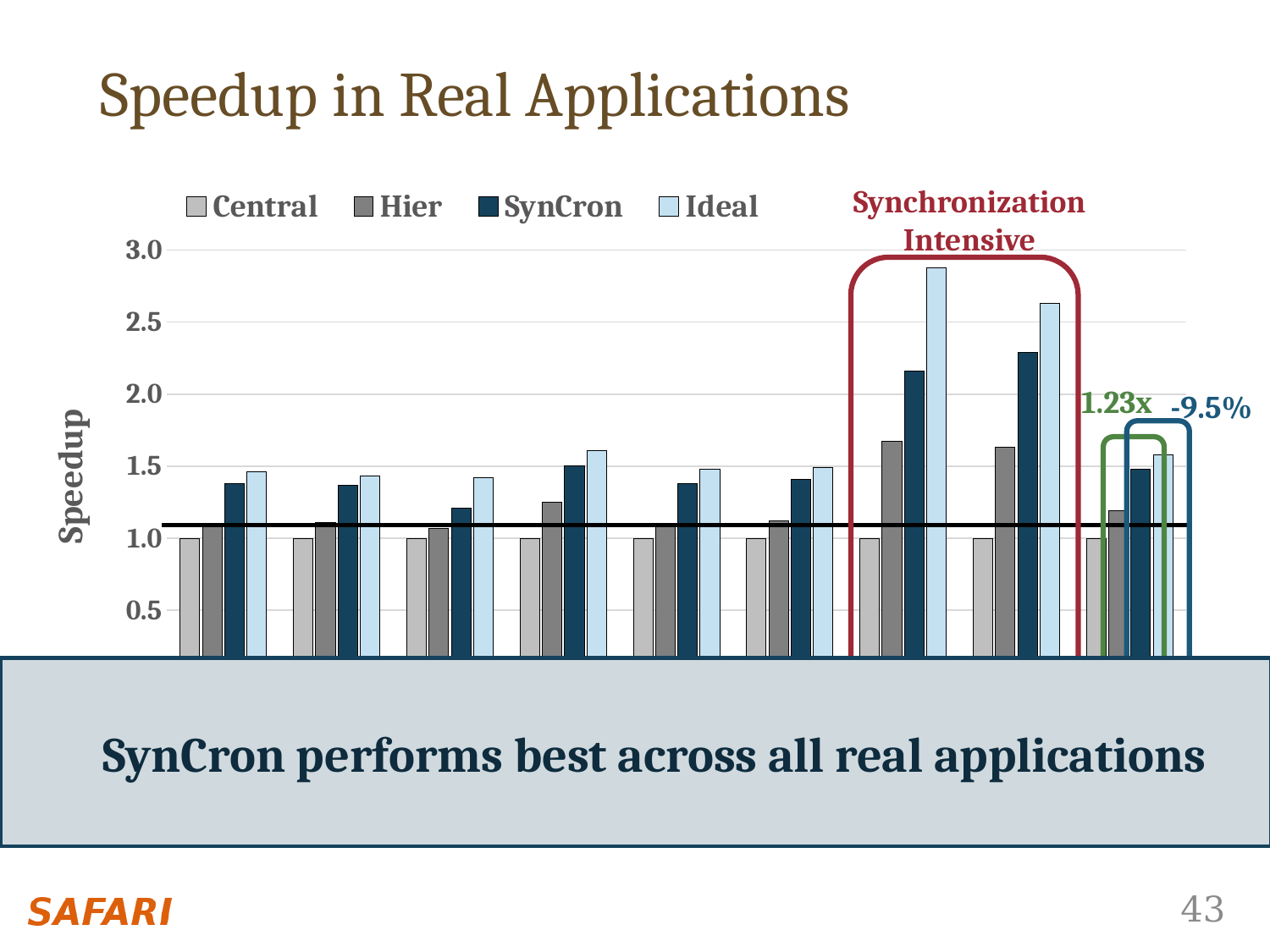
In the rightmost group, which is larger: the SynCron bar or the Hier bar? SynCron How many series does the legend list? 4 What are the four series named in the legend? Central, Hier, SynCron, Ideal What is the label of the y-axis? Speedup How many groups of bars (applications) are plotted in the chart? 9 What speedup value do the Central bars land on in every group? 1.0 Is the tallest Ideal bar greater or less than 2.5? greater What speedup factor is annotated in green above the rightmost group? 1.23x Which series has the lowest bars across all groups? Central What kind of chart is shown on the slide? Bar chart Which series has the tallest bar anywhere in the chart? Ideal Is the tallest SynCron bar greater or less than 2.0? greater